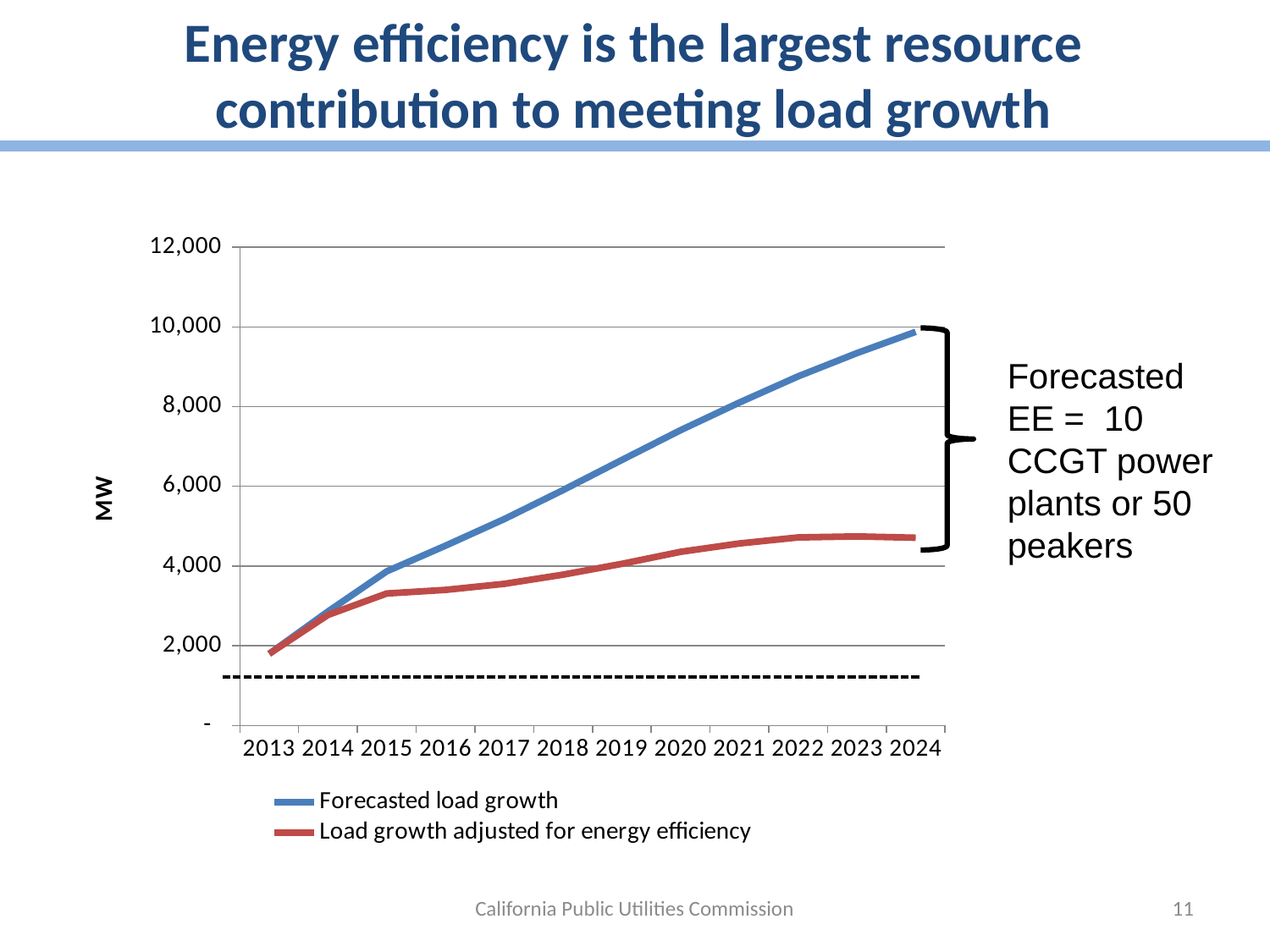
Does the Forecasted load growth series rise or fall from 2013 to 2024? rise Is the value for Load growth adjusted for energy efficiency in 2016 greater or less than 4,000? less Is the value for Load growth adjusted for energy efficiency in 2024 greater or less than 6,000? less How many series does the legend list? 2 In which year is the Forecasted load growth series at its lowest? 2013 What kind of chart is shown on the slide? line chart Is the value for Forecasted load growth in 2024 greater or less than 8,000? greater In which year is the Forecasted load growth series at its highest? 2024 In 2024, which series has the higher value: Forecasted load growth or Load growth adjusted for energy efficiency? Forecasted load growth What is the label on the y axis of the chart? MW How many years are shown along the x axis? 12